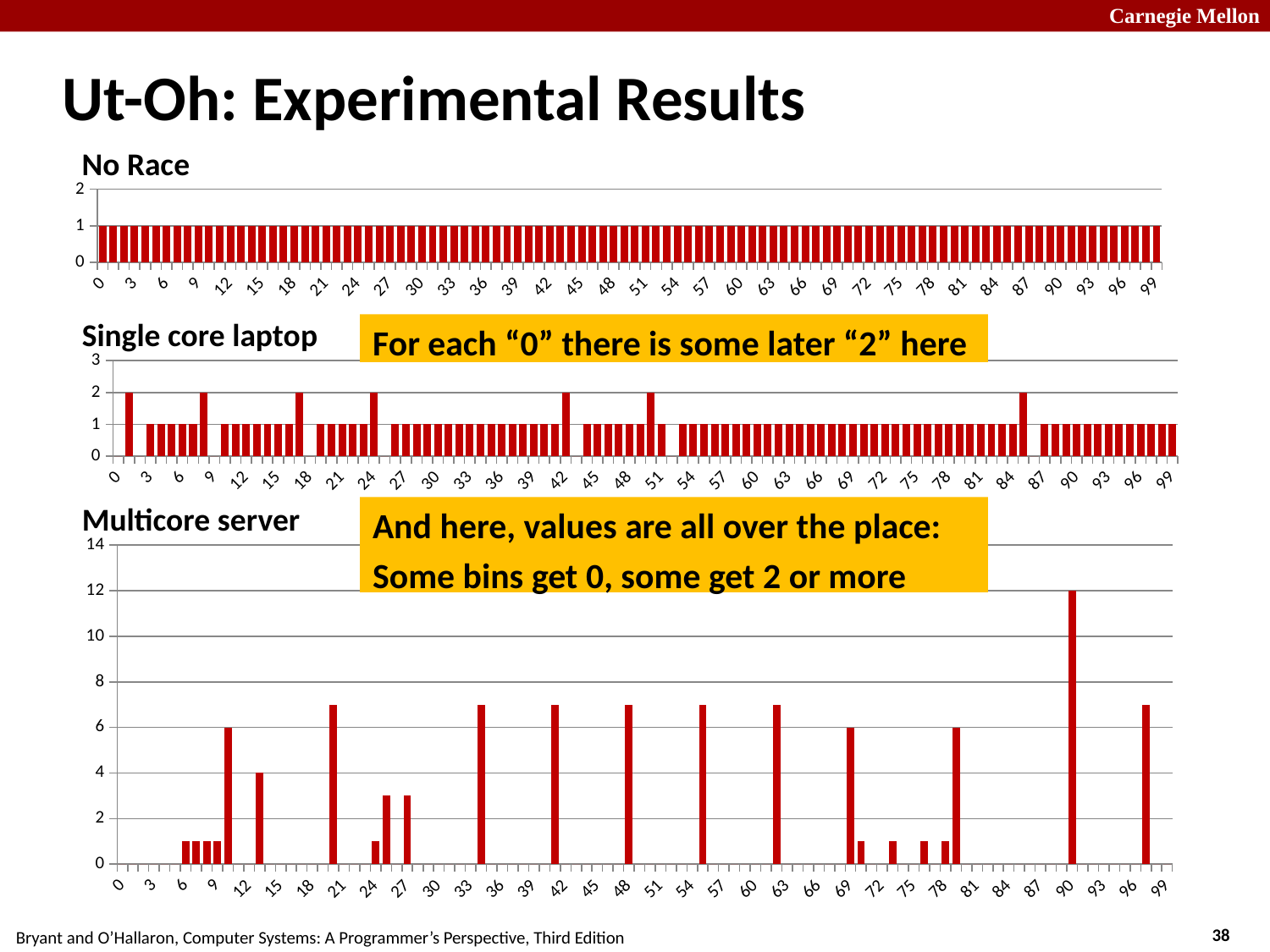
In the "Multicore server" chart, is the value for bin 13 greater or less than 6? less In the "Multicore server" chart, what is the value of the tallest bar? 12 In the "Multicore server" chart, is the value for bin 90 greater or less than 10? greater In the "Single core laptop" chart, what is the highest value reached by any bar? 2 How many charts are shown on the slide? 3 In the "Multicore server" chart, at which bin does the tallest bar occur? 90 What is the title of the middle chart on the slide? Single core laptop In the "No Race" chart, what is the value for bin 0? 1 What kind of chart is the "No Race" chart at the top of the slide? bar chart What is the maximum value shown on the y axis of the "Multicore server" chart? 14 In the "Single core laptop" chart, what is the lowest value reached by any bar? 0